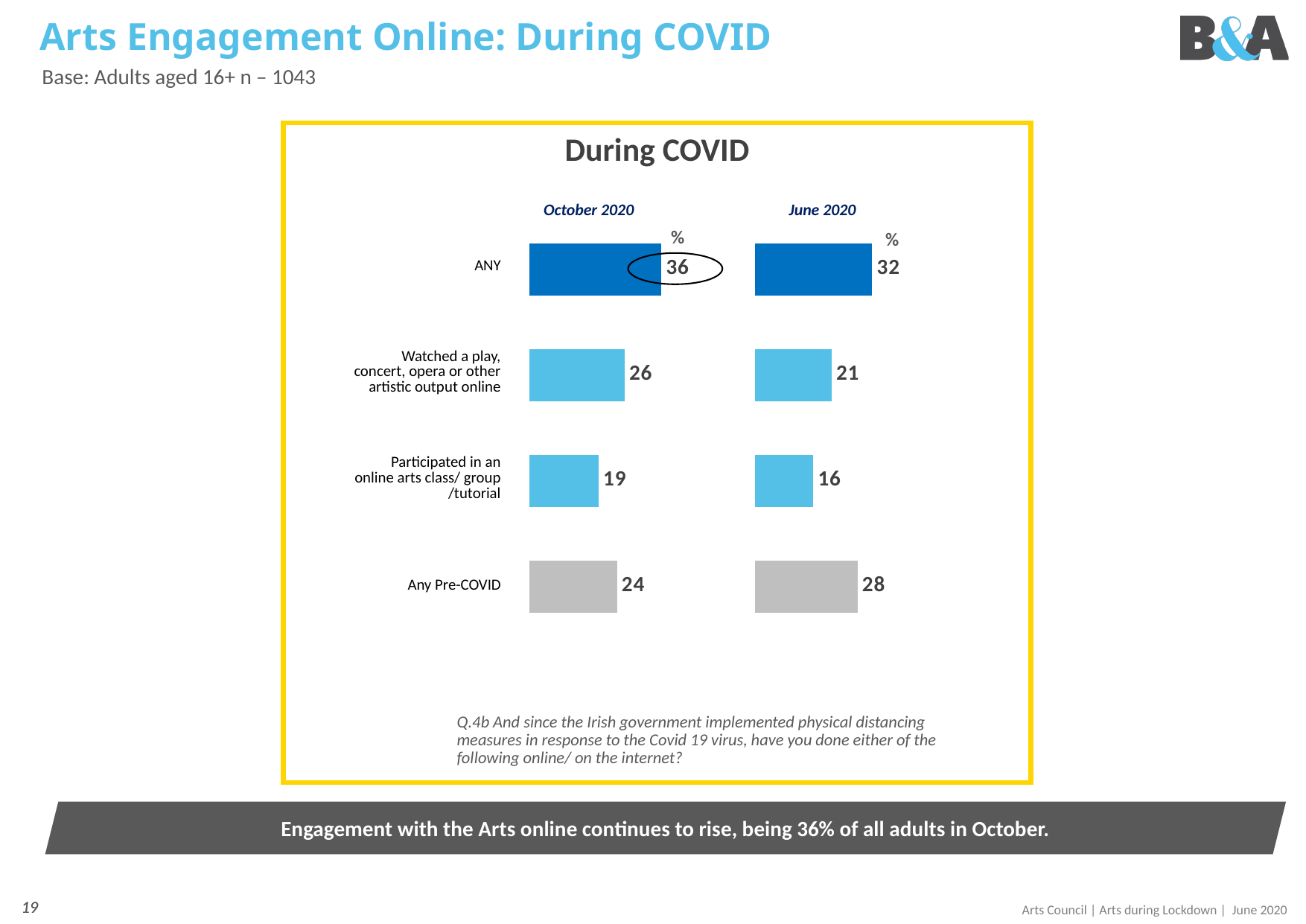
In the October 2020 chart, what is the difference between Watched a play, concert, opera or other artistic output online and Participated in an online arts class/ group /tutorial? 7 In the June 2020 chart, what is the value for Watched a play, concert, opera or other artistic output online? 21 In the June 2020 chart, which category has the lowest value? Participated in an online arts class/ group /tutorial In the June 2020 chart, what is the value for Any Pre-COVID? 28 Is the Any Pre-COVID value larger in the October 2020 chart or the June 2020 chart? June 2020 What is the difference between the ANY value in the October 2020 chart and the ANY value in the June 2020 chart? 4 How many categories are shown in the June 2020 chart? 4 What kind of chart is used for the October 2020 data? Bar chart In the October 2020 chart, which category has the highest value? ANY In the October 2020 chart, what is the value for Participated in an online arts class/ group /tutorial? 19 What is the title shown above the two charts inside the yellow box? During COVID In the October 2020 chart, what is the value for ANY? 36